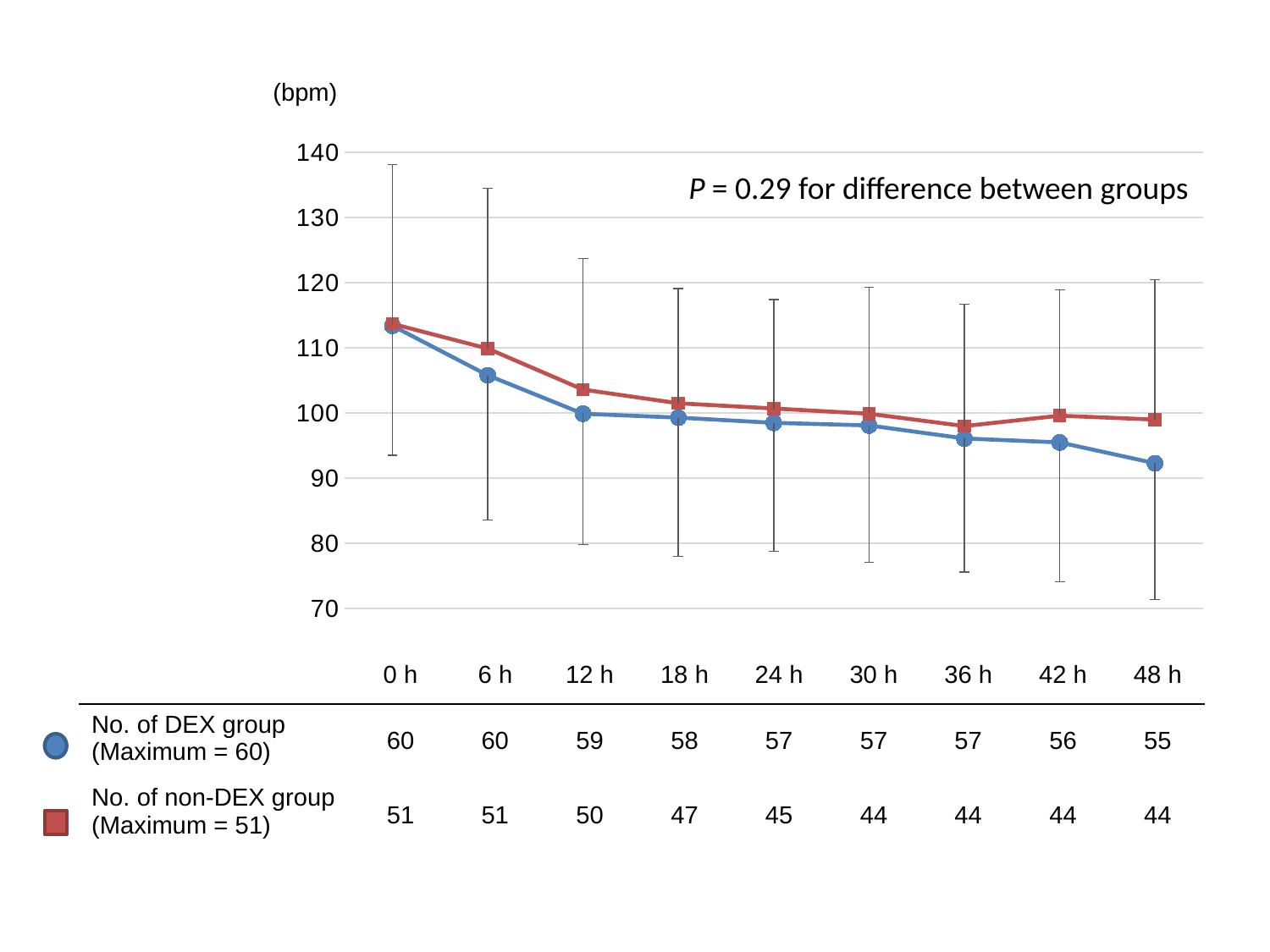
Is the value for the non-DEX group at 12 h greater or less than 100? greater Is the value for the DEX group at 6 h greater or less than 100? greater What unit is shown on the y axis? bpm At 48 h, which group has the higher value, DEX or non-DEX? non-DEX Do the values for the DEX group rise or fall from 0 h to 48 h? fall How many series (groups) are plotted in the chart? 2 Is the value for the non-DEX group at 0 h greater or less than 110? greater How many time points are plotted along the x axis? 9 What P value is reported for the difference between groups? P = 0.29 What kind of chart is shown on the slide? line chart According to the table below the chart, how many patients were in the non-DEX group at 48 h? 44